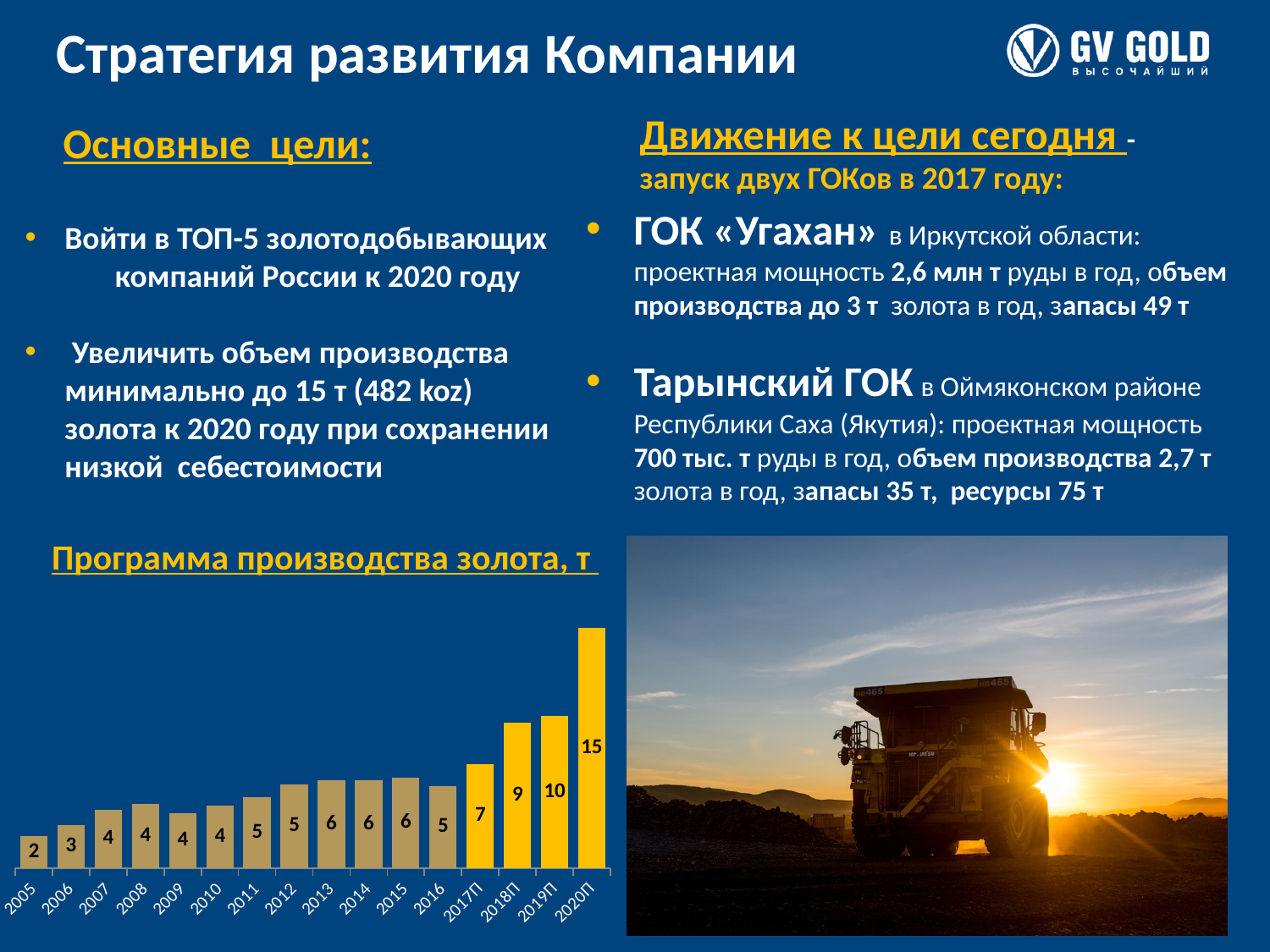
What is the value for 2020П in the 'Программа производства золота, т' chart? 15 Which year has the highest value in the 'Программа производства золота, т' chart? 2020П What is the value for 2016 in the 'Программа производства золота, т' chart? 5 Do the values in the 'Программа производства золота, т' chart generally rise or fall from 2005 to 2020П? rise What is the value for 2005 in the 'Программа производства золота, т' chart? 2 What is the difference between the values for 2020П and 2005 in the 'Программа производства золота, т' chart? 13 In the 'Программа производства золота, т' chart, which is larger: the value for 2018П or the value for 2016? 2018П What type of chart is shown under the heading 'Программа производства золота, т'? bar chart What is the value for 2018П in the 'Программа производства золота, т' chart? 9 Which year has the lowest value in the 'Программа производства золота, т' chart? 2005 How many years (categories) are shown in the 'Программа производства золота, т' chart? 16 What is the difference between the values for 2019П and 2017П in the 'Программа производства золота, т' chart? 3